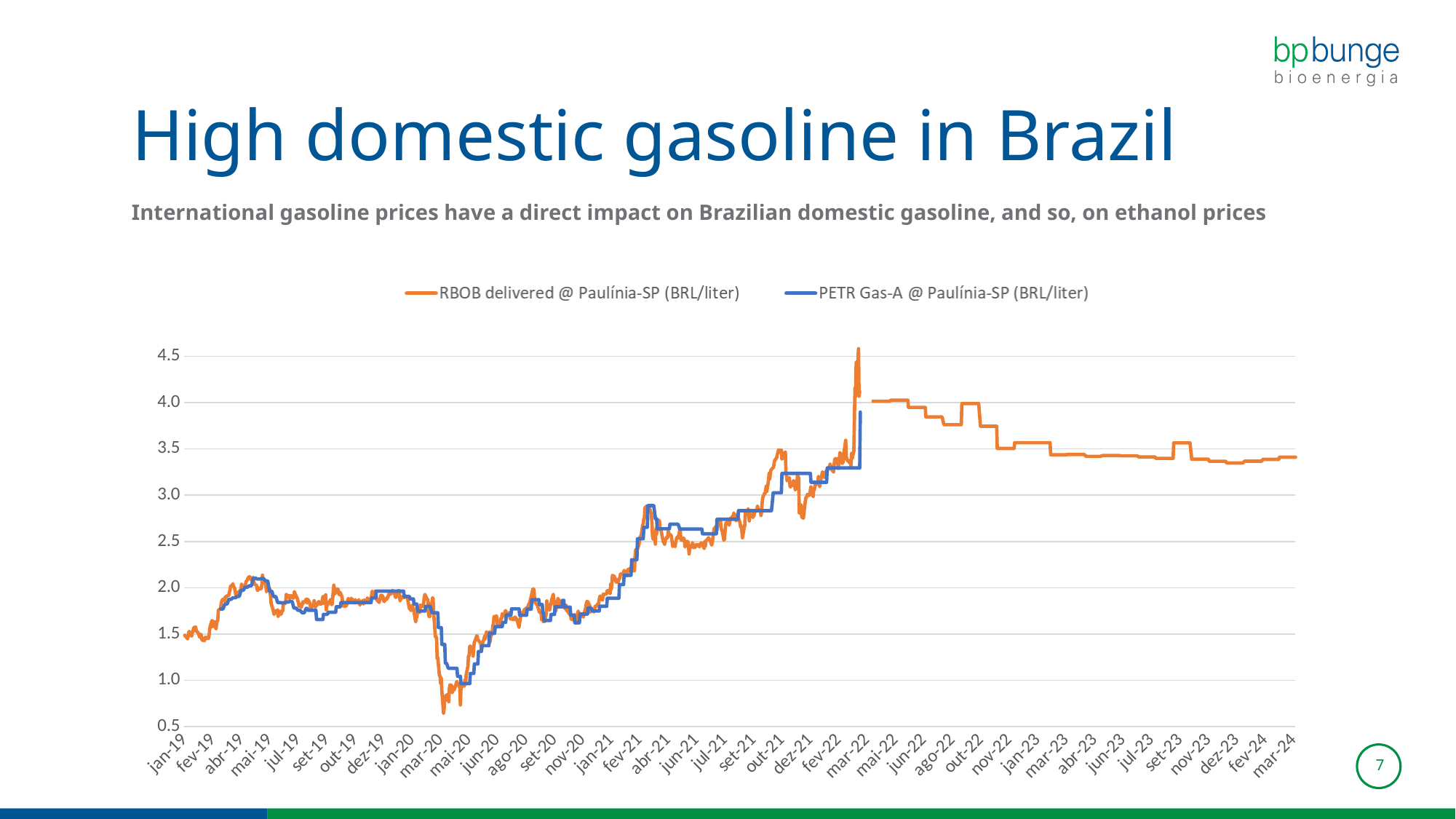
Which series is drawn in blue? PETR Gas-A @ Paulínia-SP (BRL/liter) Is the value of the RBOB delivered @ Paulínia-SP series at mar-24 greater or less than 3.0? greater How many series does the chart legend list? 2 Which series has data plotted all the way to mar-24? RBOB delivered @ Paulínia-SP (BRL/liter) Is the value of the RBOB delivered @ Paulínia-SP series at mai-22 greater or less than 3.5? greater Which series is drawn in orange? RBOB delivered @ Paulínia-SP (BRL/liter) What kind of chart is shown on the slide? Line chart Overall, do the plotted prices rise or fall between jan-19 and mar-22? rise Is the highest value reached by the RBOB delivered @ Paulínia-SP series greater or less than 4.0? greater Overall, does the RBOB delivered @ Paulínia-SP series rise or fall between mai-22 and mar-24? fall